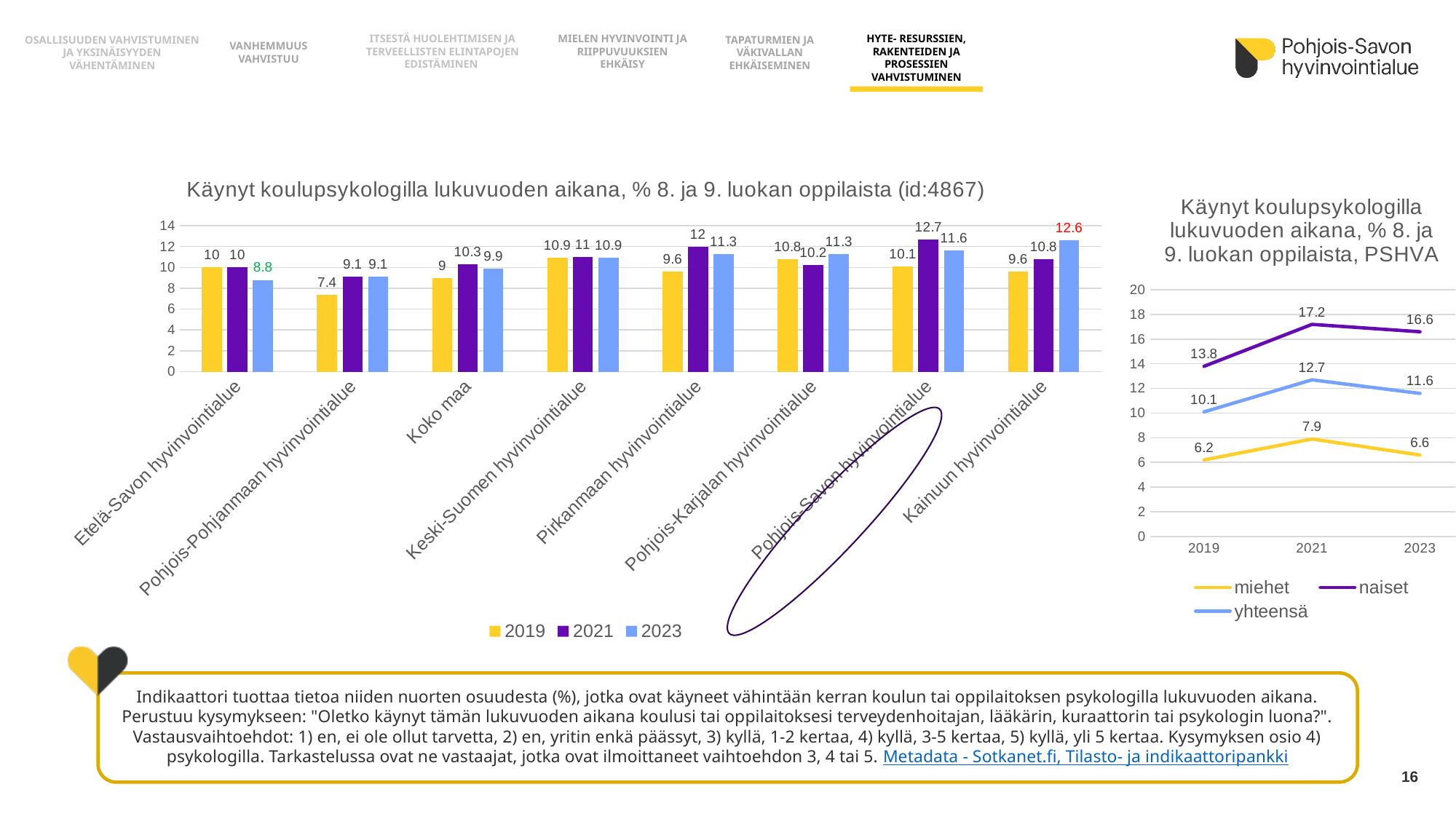
In the line chart on the right (PSHVA), how does the miehet series change from 2021 to 2023? It falls In the line chart on the right (PSHVA), what is the value for naiset in 2021? 17.2 In the bar chart on the left, what is the difference between the 2021 and 2019 values for Pirkanmaan hyvinvointialue? 2.4 In the bar chart on the left, which category has the highest 2021 value? Pohjois-Savon hyvinvointialue What type of chart is the chart on the right (PSHVA)? Line chart In the bar chart on the left, which category has the lowest 2019 value? Pohjois-Pohjanmaan hyvinvointialue In the bar chart on the left, what is the 2023 value for Kainuun hyvinvointialue? 12.6 In the bar chart on the left, is the 2023 value for Koko maa larger or smaller than the 2023 value for Pohjois-Savon hyvinvointialue? smaller In the line chart on the right (PSHVA), what is the difference between naiset and miehet in 2023? 10 In the bar chart on the left, what is the 2019 value for Pohjois-Pohjanmaan hyvinvointialue? 7.4 In the bar chart on the left, how many categories are shown on the x axis? 8 In the bar chart on the left, how many series does the legend list? 3